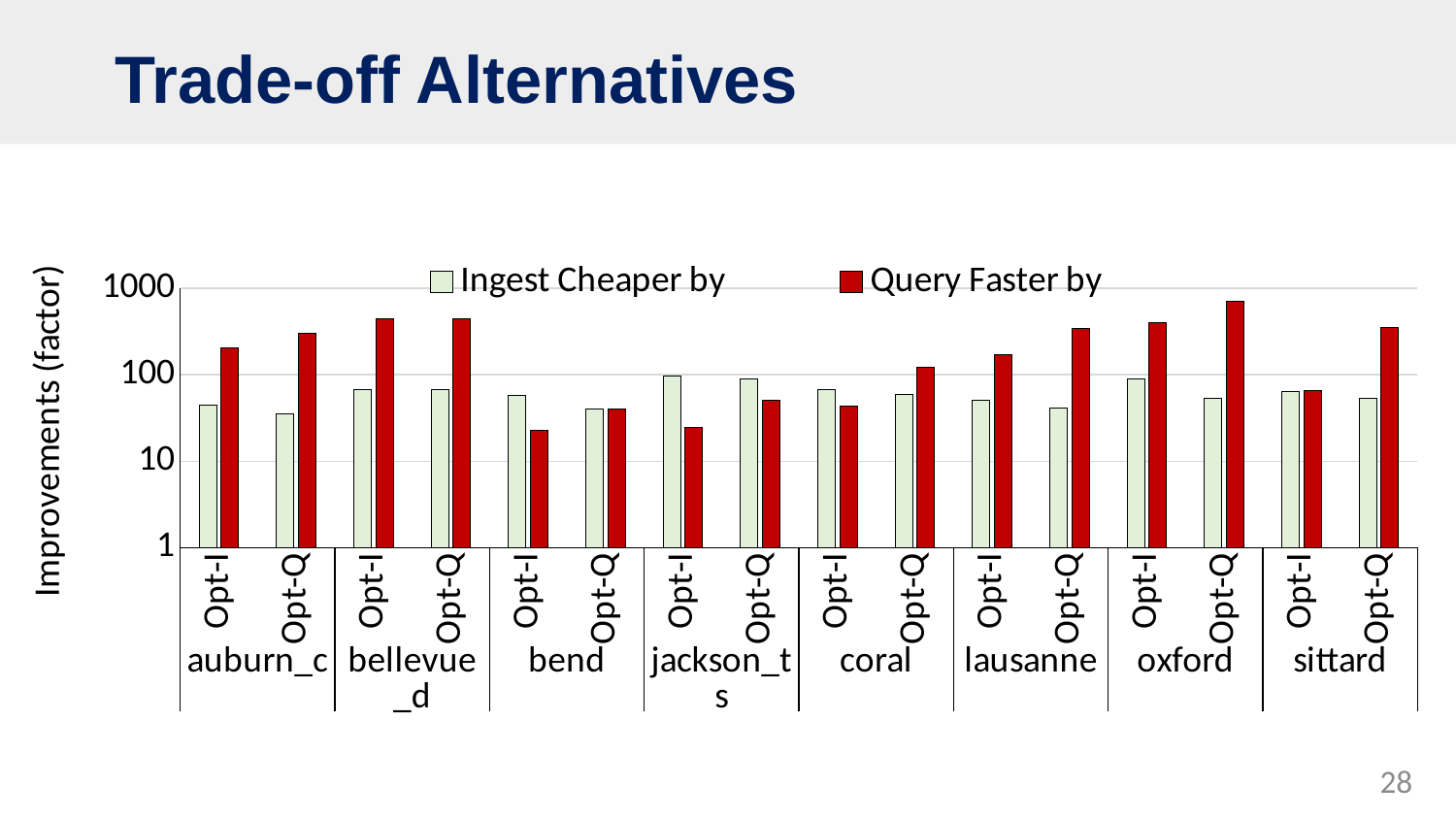
Is the Query Faster by value for bellevue_d Opt-I greater or less than 100? greater Which bar has the highest Query Faster by value? oxford Opt-Q How many datasets (auburn_c, bellevue_d, etc.) are shown along the x axis? 8 Is the Query Faster by value for oxford Opt-Q greater or less than 100? greater Which series is drawn in red? Query Faster by Is the Query Faster by value for bend Opt-I greater or less than 100? less For auburn_c Opt-I, which is larger: Ingest Cheaper by or Query Faster by? Query Faster by What kind of chart is shown on the slide? bar chart How many series does the legend list? 2 What is the label of the y axis? Improvements (factor) For jackson_ts Opt-I, which is larger: Ingest Cheaper by or Query Faster by? Ingest Cheaper by